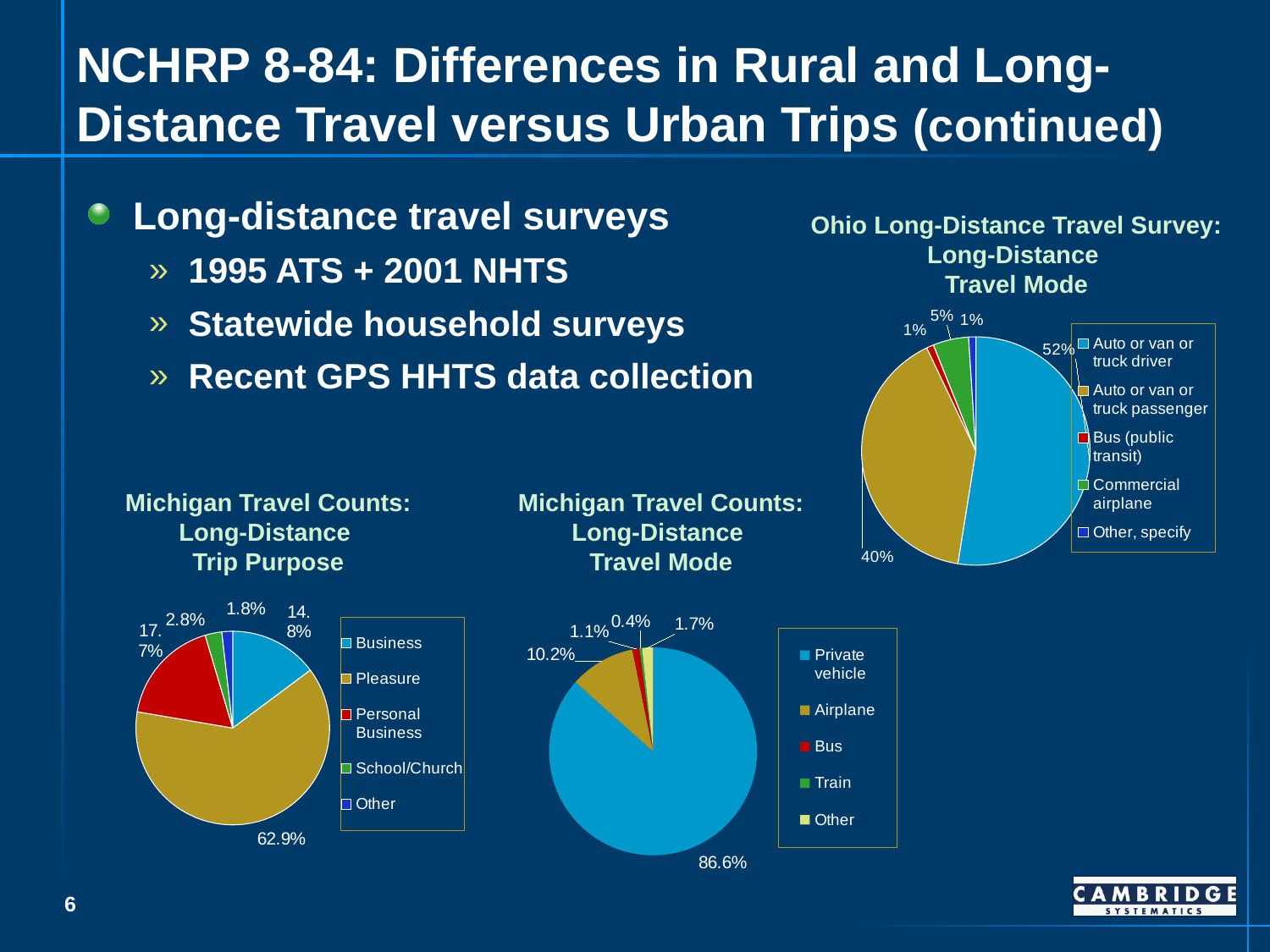
In the Ohio Long-Distance Travel Survey: Long-Distance Travel Mode chart, which mode has the largest share? Auto or van or truck driver In the Michigan Travel Counts: Long-Distance Travel Mode chart, what share is Airplane? 10.2% In the Michigan Travel Counts: Long-Distance Travel Mode chart, which is larger, the Bus share or the Other share? Other In the Michigan Travel Counts: Long-Distance Travel Mode chart, what share is Private vehicle? 86.6% In the Michigan Travel Counts: Long-Distance Trip Purpose chart, what is the difference between the Pleasure share and the Business share? 48.1% In the Michigan Travel Counts: Long-Distance Trip Purpose chart, which trip purpose has the smallest share? Other In the Ohio Long-Distance Travel Survey: Long-Distance Travel Mode chart, what share is Auto or van or truck passenger? 40% In the Ohio Long-Distance Travel Survey: Long-Distance Travel Mode chart, what share is Commercial airplane? 5% In the Michigan Travel Counts: Long-Distance Trip Purpose chart, what share is Personal Business? 17.7% How many categories does the legend of the Michigan Travel Counts: Long-Distance Travel Mode chart list? 5 In the Michigan Travel Counts: Long-Distance Trip Purpose chart, what share is Pleasure? 62.9% In the Ohio Long-Distance Travel Survey: Long-Distance Travel Mode chart, what share is Auto or van or truck driver? 52%